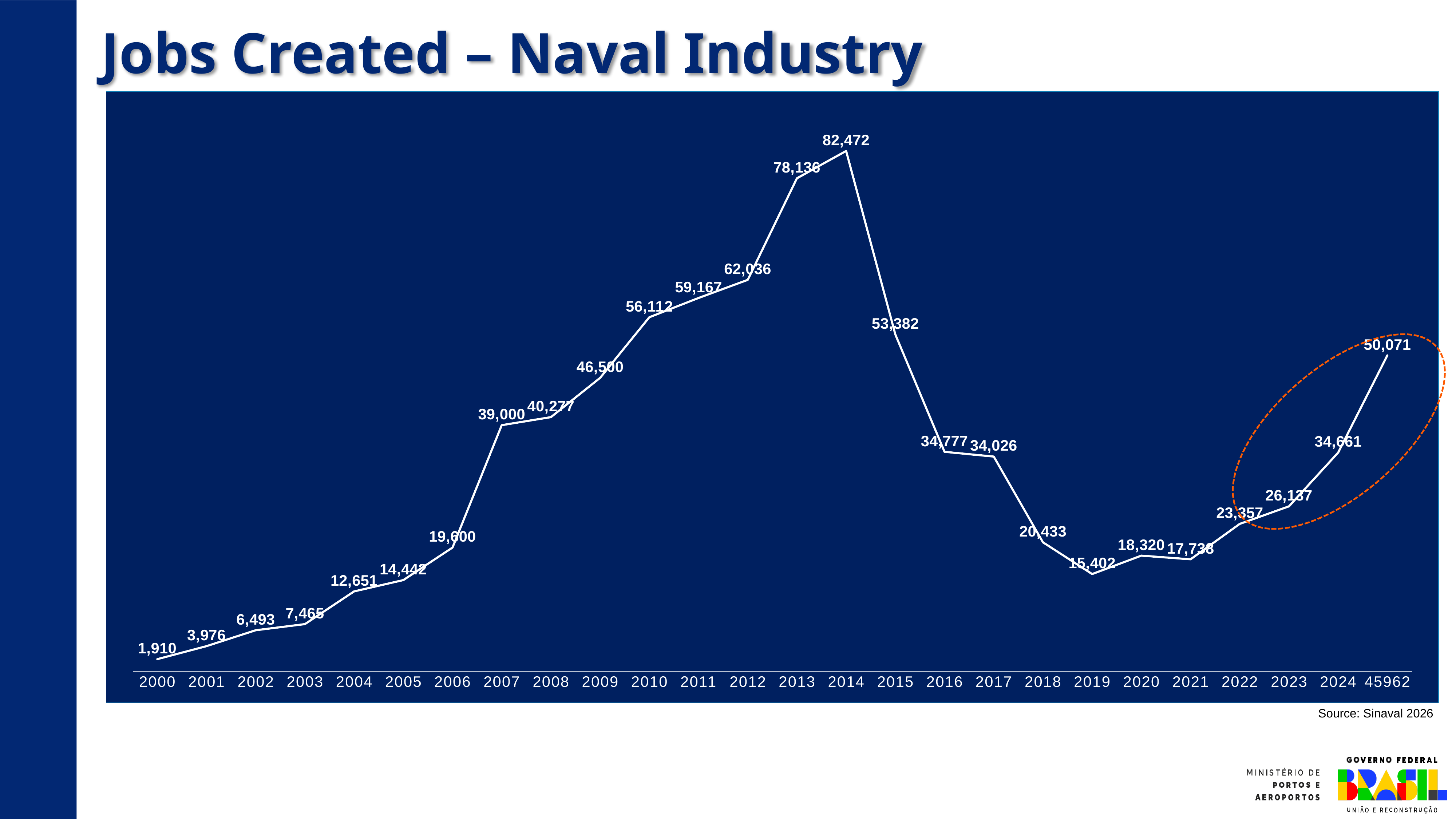
What is the difference between the values for 2024 and 2023? 8,524 What is the value shown for 2019? 15,402 Which year has the lowest number of jobs created? 2000 What is the difference between the values for 2014 and 2013? 4,336 What type of chart is shown on the slide? line chart What is the value shown for 2007? 39,000 Do the values rise or fall from 2014 to 2019? fall What is the value shown for 2024? 34,661 Which year has the highest number of jobs created? 2014 What is the title of the slide? Jobs Created – Naval Industry Which year has a larger value, 2016 or 2017? 2016 How many jobs were created in the naval industry in 2014? 82,472